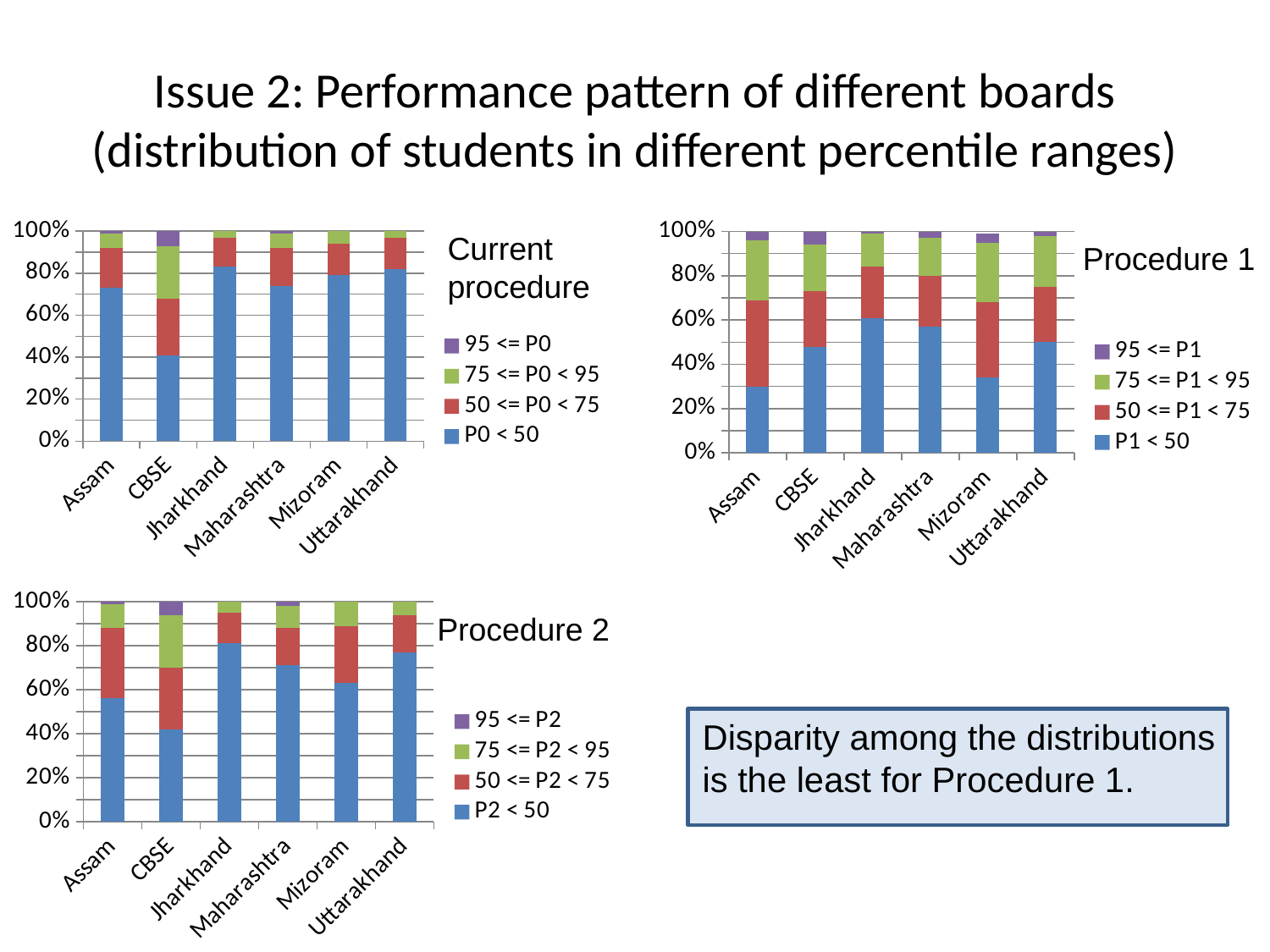
In the Procedure 1 chart, which board has the lowest share of students with P1 < 50? Assam What kind of chart is the Current procedure chart? stacked bar chart In the Current procedure chart, which board has the lowest share of students with P0 < 50? CBSE How many series does the legend of the Procedure 2 chart list? 4 In the Procedure 2 chart, is the share of students with P2 < 50 for Maharashtra greater or less than 60%? greater Which legend entry in the Procedure 1 chart is shown in blue? P1 < 50 In the Current procedure chart, which board has the larger share of students with P0 < 50, Assam or CBSE? Assam How many boards are shown on the x axis of the Procedure 1 chart? 6 In the Procedure 1 chart, which board has the larger share of students with P1 < 50, Jharkhand or Mizoram? Jharkhand In the Procedure 1 chart, is the share of students with P1 < 50 for Assam greater or less than 40%? less In the Procedure 2 chart, which board has the lowest share of students with P2 < 50? CBSE In the Current procedure chart, is the share of students with P0 < 50 for CBSE greater or less than 60%? less